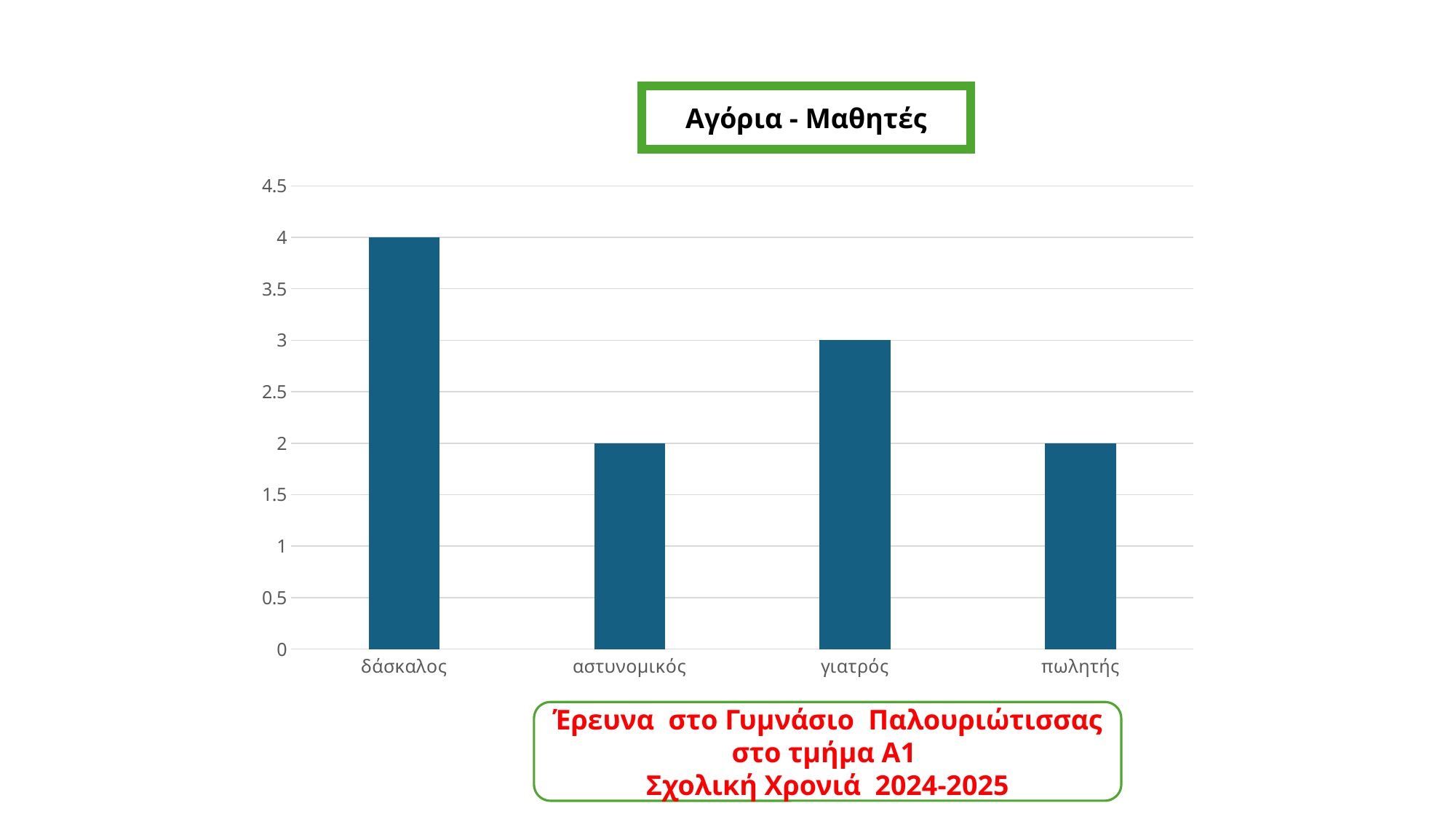
Is the value for γιατρός greater or less than 2.5? greater What is the value for γιατρός? 3 What is the title of the chart? Αγόρια - Μαθητές Which is larger, the value for γιατρός or the value for αστυνομικός? γιατρός What kind of chart is shown on the slide? bar chart What is the difference between the values for δάσκαλος and γιατρός? 1 What is the value for αστυνομικός? 2 What is the difference between the values for δάσκαλος and πωλητής? 2 Which category has the highest value? δάσκαλος What is the value for δάσκαλος? 4 How many categories are shown on the x axis? 4 What is the value for πωλητής? 2